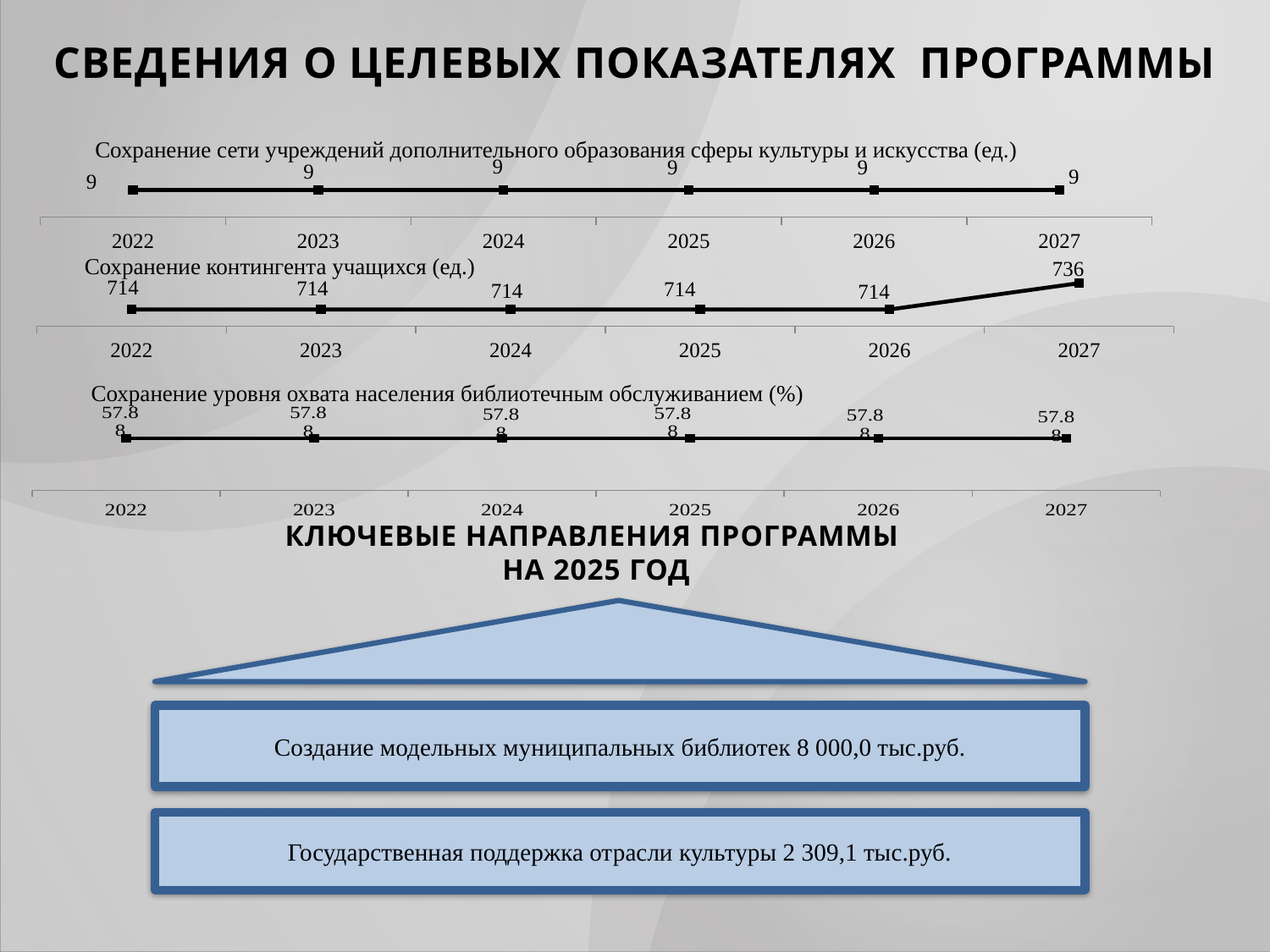
In the chart titled "Сохранение контингента учащихся (ед.)", which is larger, the value for 2027 or the value for 2022? 2027 How many charts are shown on the slide? 3 In the chart titled "Сохранение контингента учащихся (ед.)", what is the value for 2024? 714 In the chart titled "Сохранение контингента учащихся (ед.)", what is the difference between the values for 2027 and 2026? 22 In the chart titled "Сохранение сети учреждений дополнительного образования сферы культуры и искусства (ед.)", what is the value for 2025? 9 In the chart titled "Сохранение контингента учащихся (ед.)", do the values rise, fall or stay flat from 2022 to 2026? stay flat How many years are plotted on the x axis of the chart titled "Сохранение сети учреждений дополнительного образования сферы культуры и искусства (ед.)"? 6 In the chart titled "Сохранение контингента учащихся (ед.)", which year has the highest value? 2027 What kind of chart is the chart titled "Сохранение контингента учащихся (ед.)"? line chart In the chart titled "Сохранение сети учреждений дополнительного образования сферы культуры и искусства (ед.)", do the values rise, fall or stay flat from 2022 to 2027? stay flat How many data points are plotted in the chart titled "Сохранение уровня охвата населения библиотечным обслуживанием (%)"? 6 In the chart titled "Сохранение контингента учащихся (ед.)", what is the value for 2027? 736